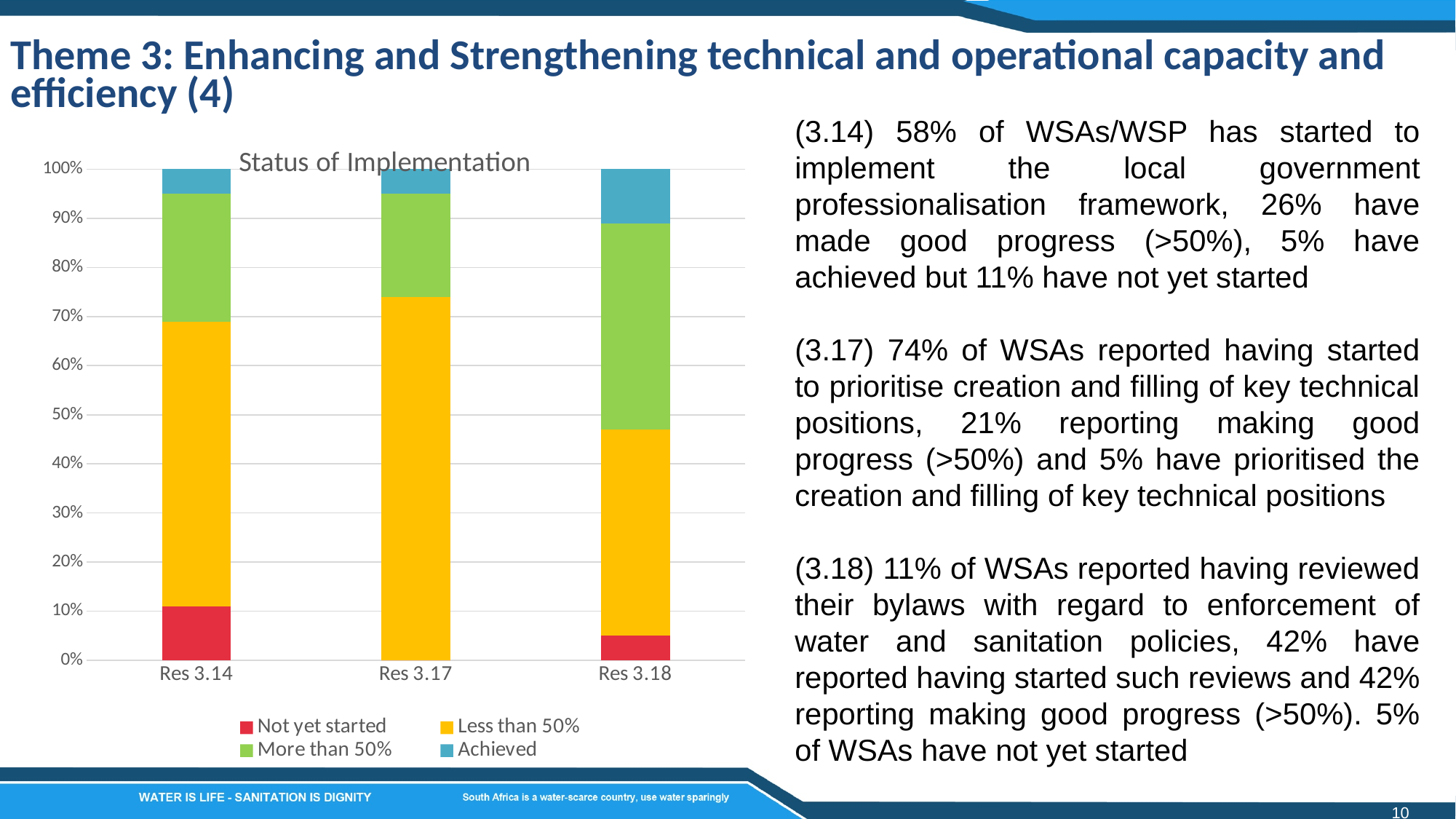
Is the 'Less than 50%' segment larger for Res 3.17 or Res 3.18? Res 3.17 Which category has the largest 'Achieved' segment? Res 3.18 Is the 'Less than 50%' value for Res 3.17 greater or less than 70%? greater Is the 'Not yet started' value for Res 3.14 greater or less than 20%? less Which category has no 'Not yet started' segment at all? Res 3.17 How many series does the chart's legend list? 4 Which category has the largest 'More than 50%' segment? Res 3.18 What kind of chart is shown on the slide? Stacked bar chart What is the title of the chart? Status of Implementation How many categories are shown on the x axis of the chart? 3 Which category has the largest 'Less than 50%' segment? Res 3.17 Is the 'Not yet started' segment larger for Res 3.14 or Res 3.18? Res 3.14